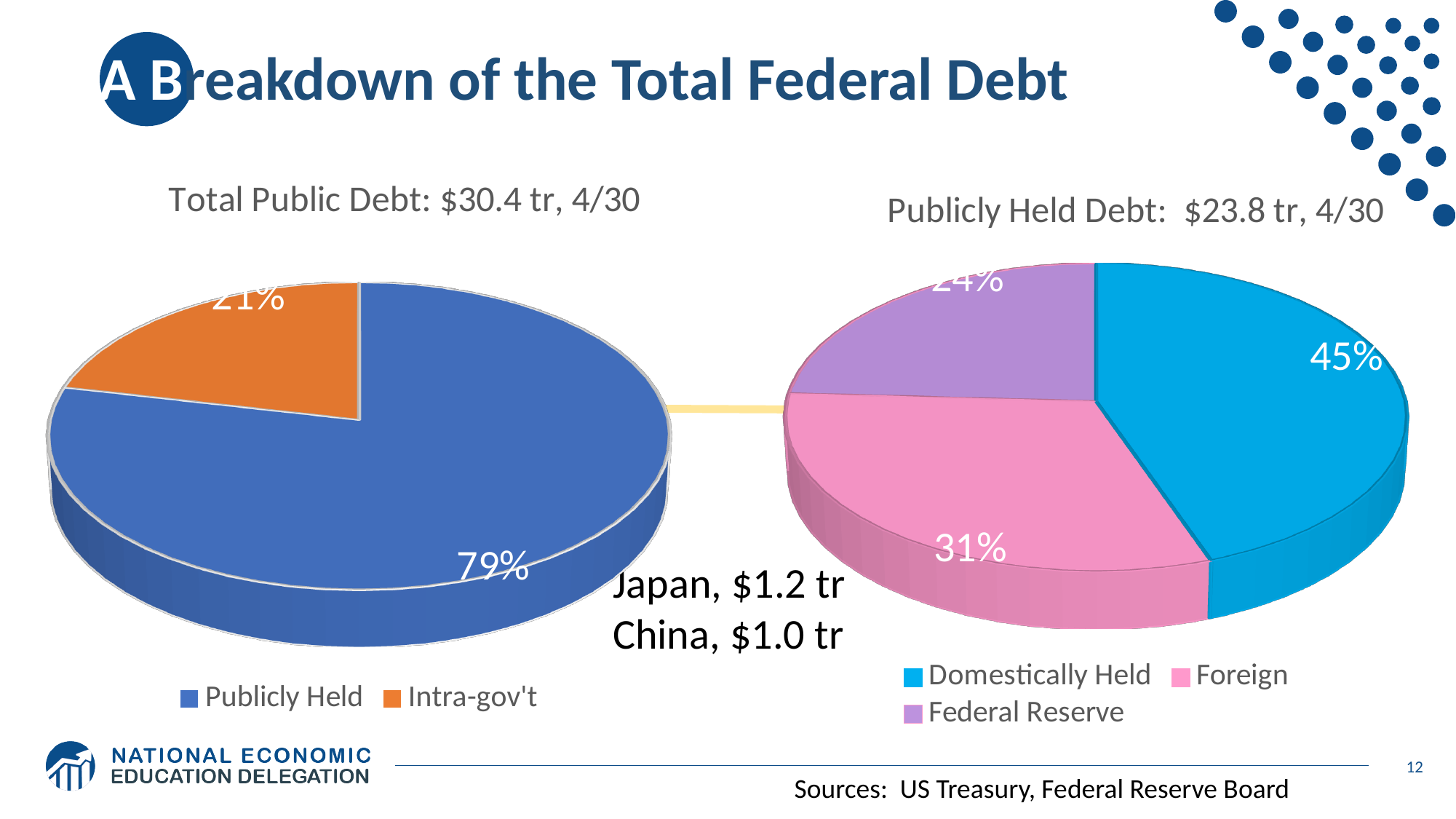
In the 'Publicly Held Debt' chart, what share is Domestically Held? 45% What kind of chart is the 'Total Public Debt' chart on the left? pie chart What colour is the Foreign slice in the 'Publicly Held Debt' chart? pink How many entries does the legend of the 'Publicly Held Debt' chart list? 3 In the 'Total Public Debt' chart, what share is Publicly Held? 79% In the 'Total Public Debt' chart, which slice is the largest? Publicly Held How many slices does the 'Total Public Debt' chart have? 2 In the 'Publicly Held Debt' chart, what share is Foreign? 31% In the 'Publicly Held Debt' chart, what is the difference in percentage points between Domestically Held and Foreign? 14 In the 'Publicly Held Debt' chart, which is larger: Domestically Held or Foreign? Domestically Held In the 'Publicly Held Debt' chart, which slice is the smallest? Federal Reserve